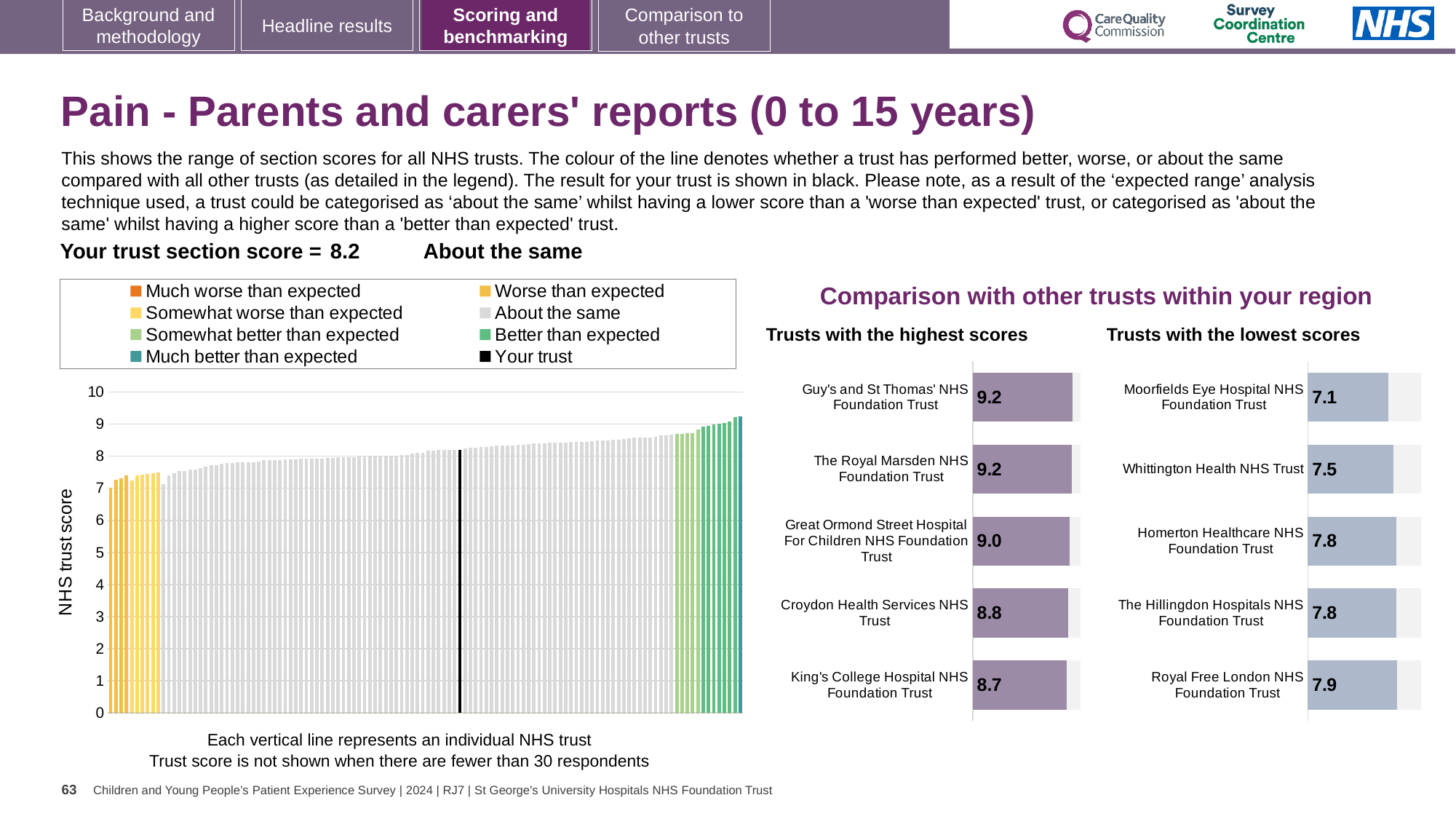
In the 'Trusts with the highest scores' chart, what is the score for Croydon Health Services NHS Trust? 8.8 What kind of chart is the large chart on the left showing the range of section scores for all NHS trusts? bar chart In the 'Trusts with the highest scores' chart, what is the score for Guy's and St Thomas' NHS Foundation Trust? 9.2 In the 'Trusts with the highest scores' chart, how many trusts are listed? 5 In the 'Trusts with the highest scores' chart, what is the difference between the scores of Guy's and St Thomas' NHS Foundation Trust and King's College Hospital NHS Foundation Trust? 0.5 In the 'Trusts with the lowest scores' chart, what is the difference between the scores of Royal Free London NHS Foundation Trust and Moorfields Eye Hospital NHS Foundation Trust? 0.8 In the 'Trusts with the lowest scores' chart, what is the score for Moorfields Eye Hospital NHS Foundation Trust? 7.1 How many entries does the legend of the large chart on the left list? 8 In the 'Trusts with the highest scores' chart, which trust has the lowest score? King's College Hospital NHS Foundation Trust In the 'Trusts with the lowest scores' chart, which has the larger score: Whittington Health NHS Trust or Homerton Healthcare NHS Foundation Trust? Homerton Healthcare NHS Foundation Trust In the large chart on the left, what is the label on the vertical axis? NHS trust score In the 'Trusts with the lowest scores' chart, which trust has the highest score? Royal Free London NHS Foundation Trust